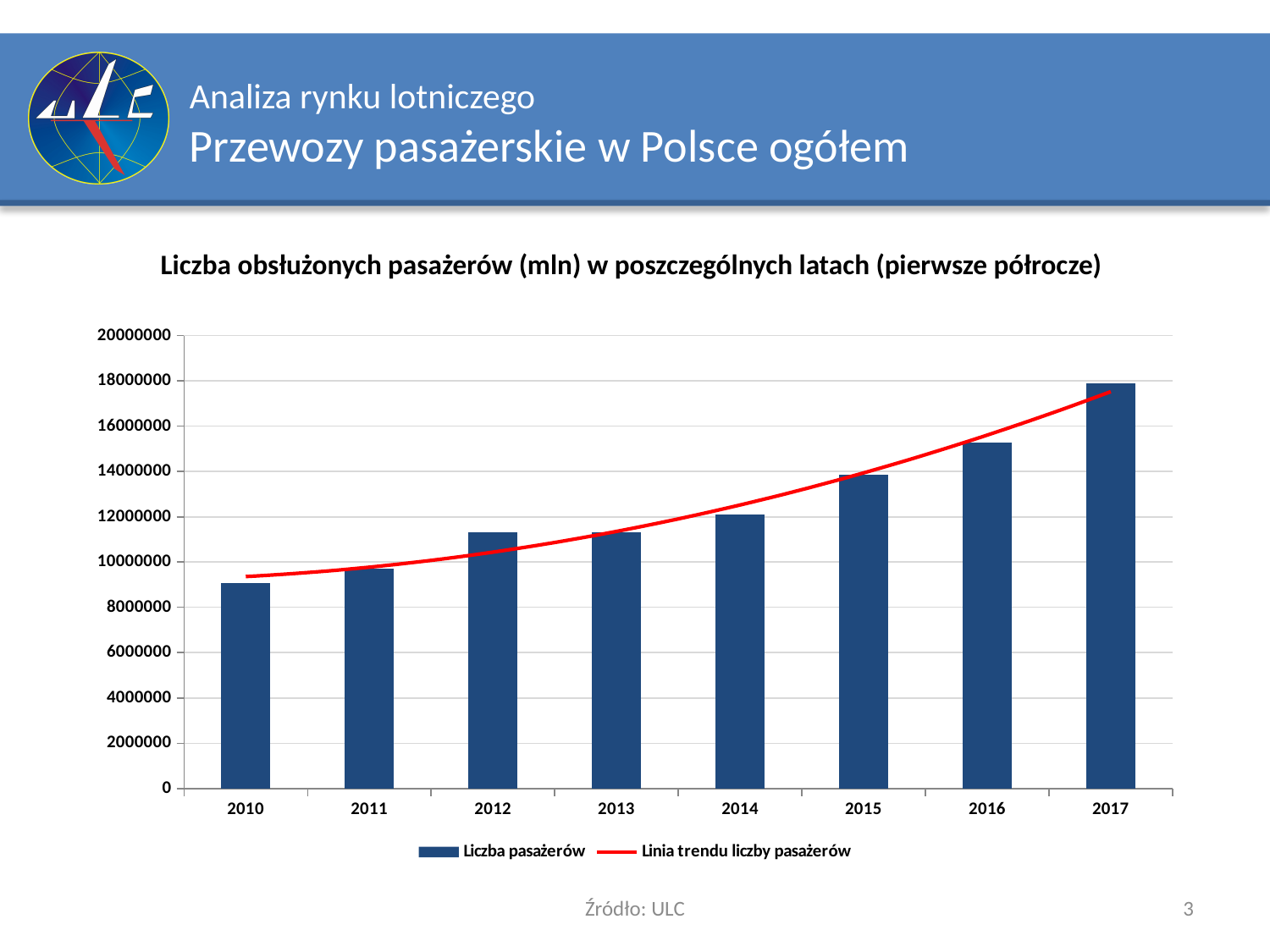
How many years are shown on the x axis of the chart? 8 What does the red line in the chart represent according to the legend? Linia trendu liczby pasażerów What is the title of the chart? Liczba obsłużonych pasażerów (mln) w poszczególnych latach (pierwsze półrocze) Is the value for 2010 greater or less than 10000000? less Is the value for 2017 greater or less than 16000000? greater Is the value for 2015 greater or less than 12000000? greater How many series does the chart legend list? 2 What kind of chart is shown on the slide? bar chart Which year has a larger value, 2016 or 2014? 2016 Which year has the lowest number of passengers in the chart? 2010 Which year has the highest number of passengers in the chart? 2017 Do the passenger numbers generally rise or fall from 2010 to 2017? rise